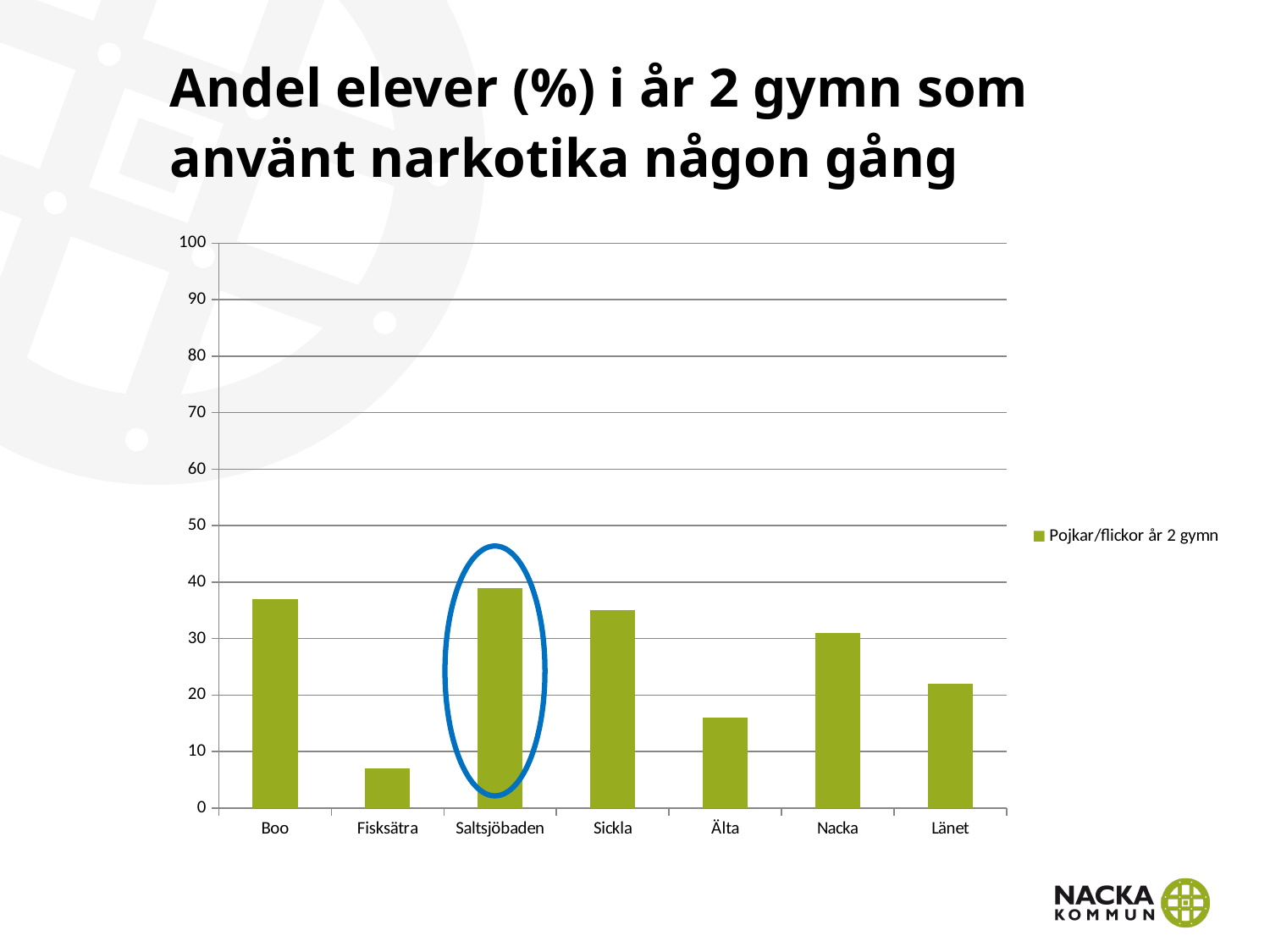
Is the value for Boo greater or less than 30? greater Which category has the highest value? Saltsjöbaden Is the value for Fisksätra greater or less than 10? less Is the value for Sickla greater or less than 30? greater How many categories are shown on the x axis? 7 Which category has the lowest value? Fisksätra How many series does the legend list? 1 Which is larger, the value for Boo or the value for Nacka? Boo What kind of chart is shown on the slide? bar chart What is the legend entry for the series shown? Pojkar/flickor år 2 gymn Which is larger, the value for Älta or the value for Länet? Länet